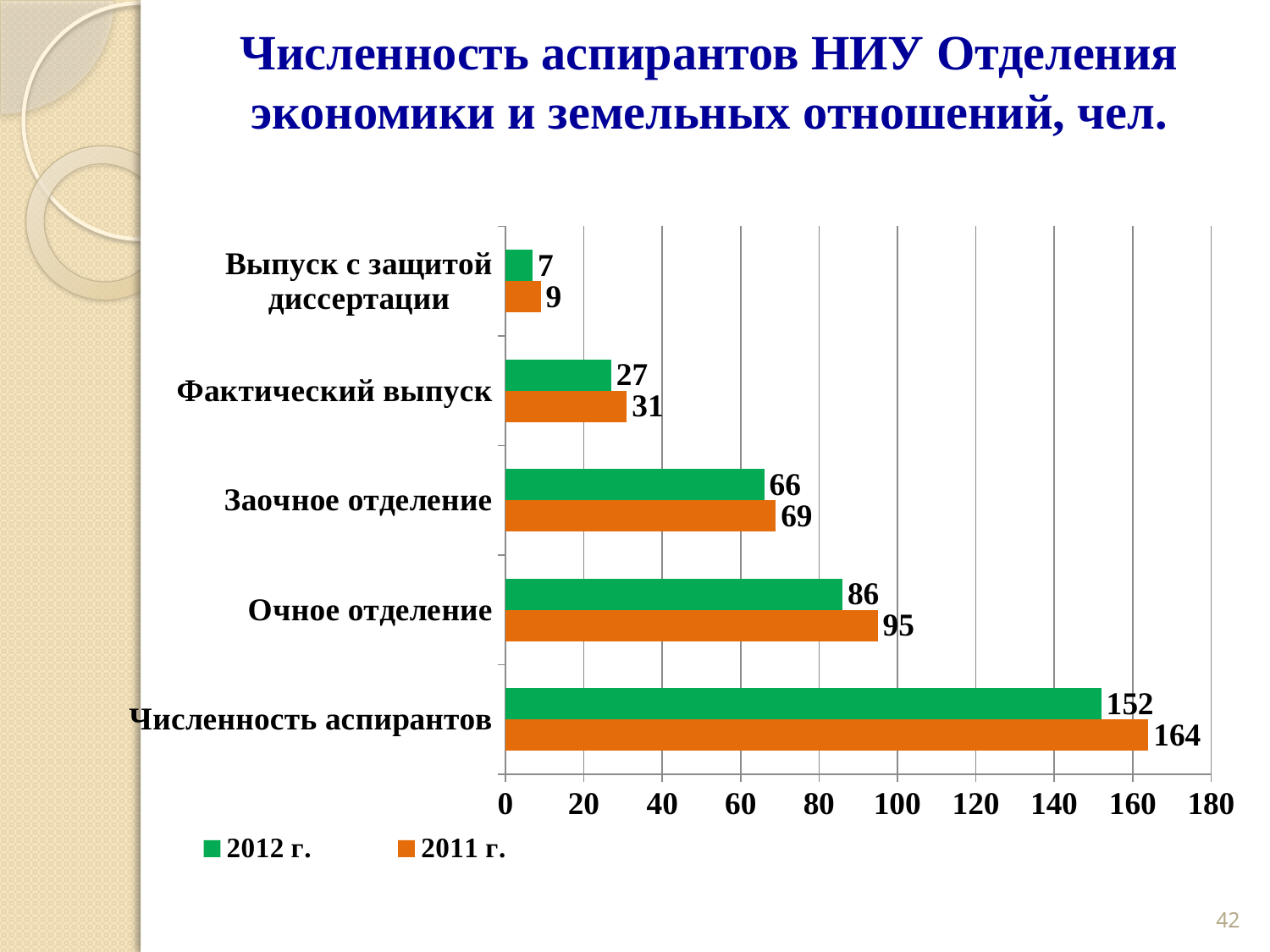
What is the difference between the 2011 г. and 2012 г. values for Численность аспирантов? 12 What is the value for Выпуск с защитой диссертации in 2011 г.? 9 How many categories are shown on the chart? 5 How many series does the legend list? 2 Which is larger for Заочное отделение: the 2012 г. value or the 2011 г. value? 2011 г. Is the 2011 г. value for Очное отделение greater or less than 100? less Which category has the highest value in 2012 г.? Численность аспирантов Which category has the lowest value in 2011 г.? Выпуск с защитой диссертации What is the value for Численность аспирантов in 2011 г.? 164 What kind of chart is shown on the slide? bar chart What is the value for Очное отделение in 2012 г.? 86 What is the difference between the 2011 г. and 2012 г. values for Фактический выпуск? 4